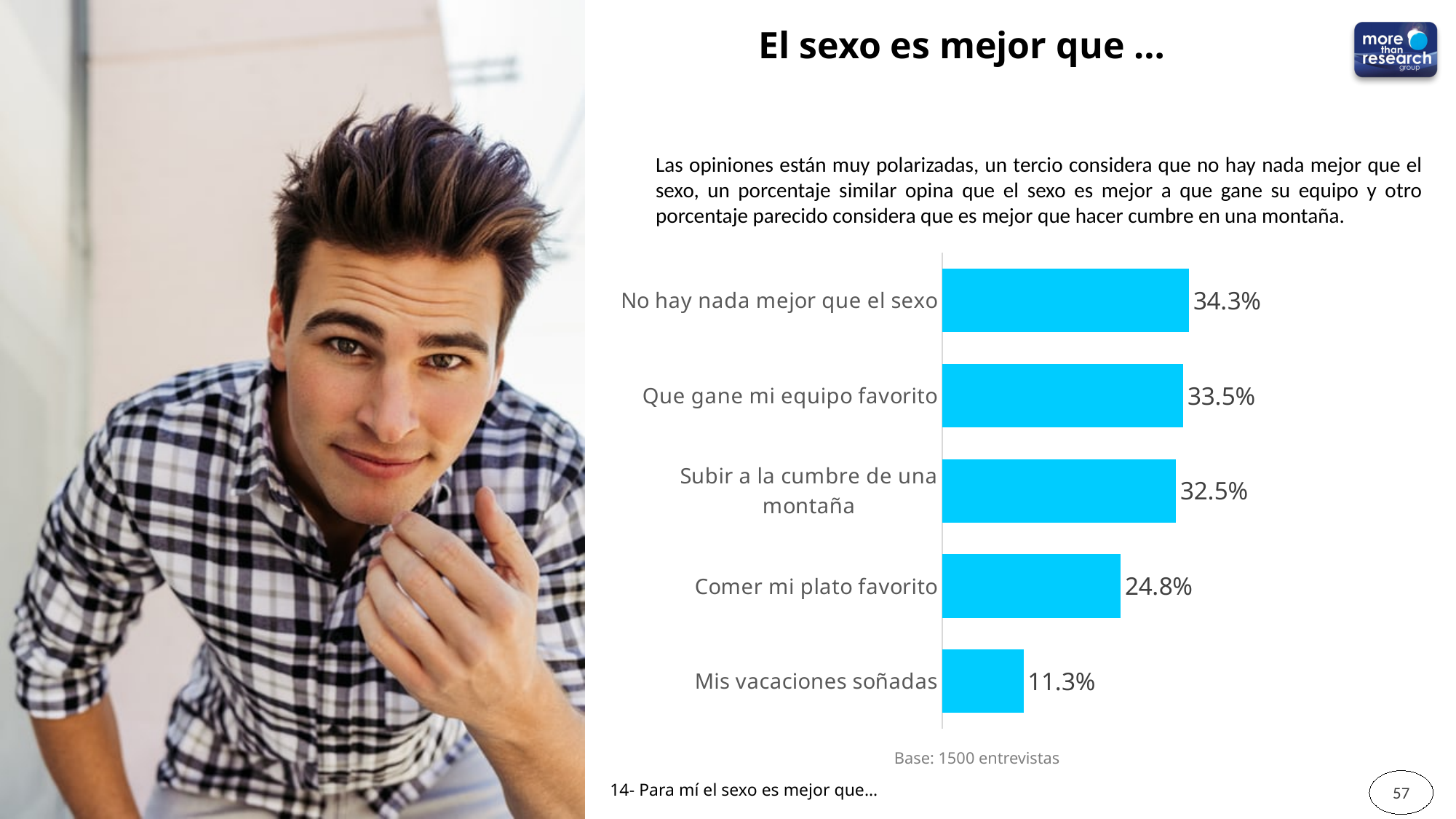
How many categories are shown in the chart? 5 What is the value for "Comer mi plato favorito"? 24.8% What is the value for "Subir a la cumbre de una montaña"? 32.5% What is the difference between "No hay nada mejor que el sexo" and "Mis vacaciones soñadas"? 23 percentage points What is the value for "Que gane mi equipo favorito"? 33.5% Which category has the highest value? No hay nada mejor que el sexo What is the difference between "Comer mi plato favorito" and "Mis vacaciones soñadas"? 13.5 percentage points What is the value for "Mis vacaciones soñadas"? 11.3% What is the value for "No hay nada mejor que el sexo"? 34.3% Which is larger, the value for "Comer mi plato favorito" or the value for "Mis vacaciones soñadas"? Comer mi plato favorito Which category has the lowest value? Mis vacaciones soñadas What kind of chart is shown on the slide? Bar chart